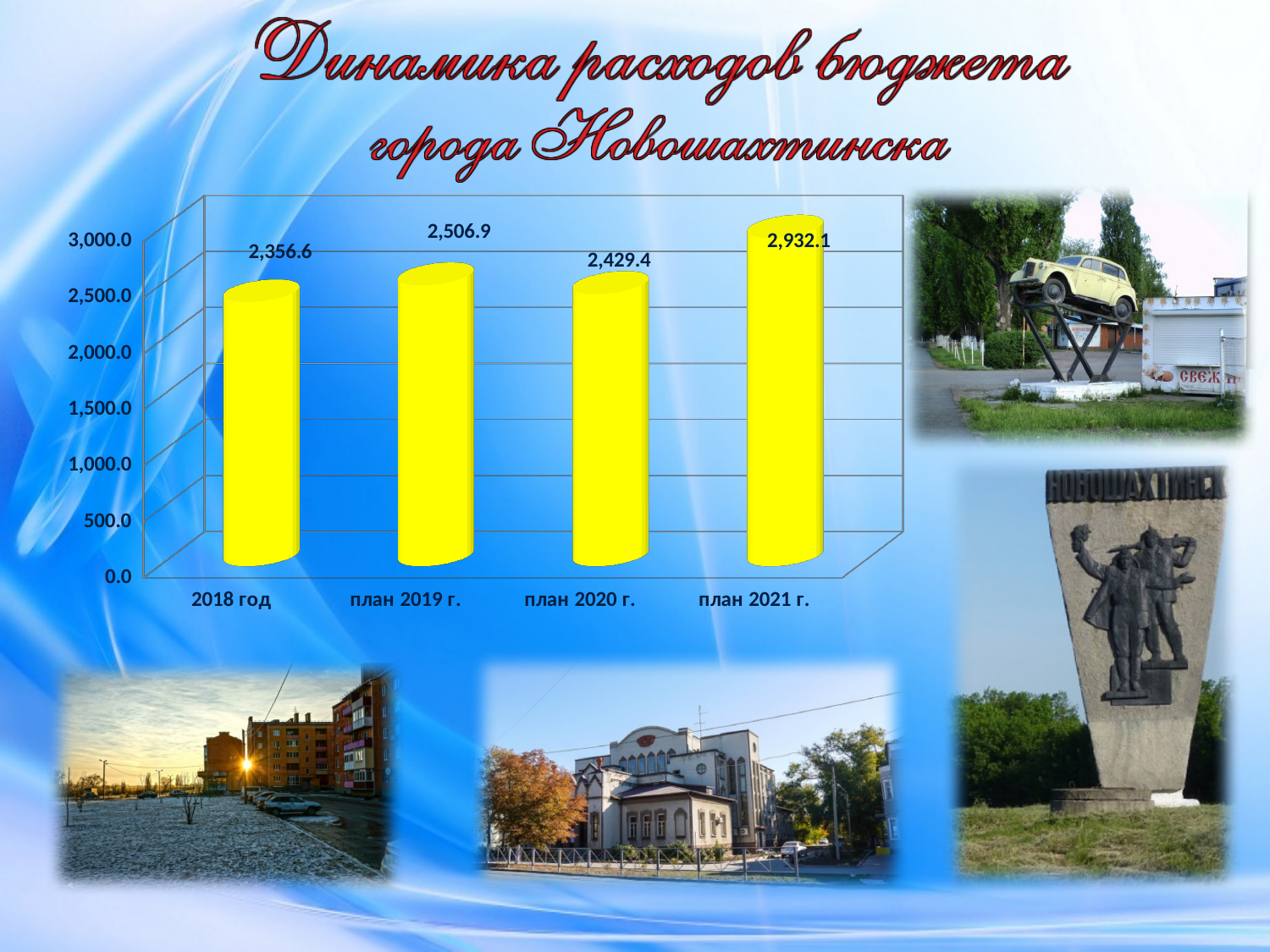
Is the value for 2018 год greater or less than 2,500.0? less What is the value for план 2021 г.? 2,932.1 Which is larger, the value for план 2019 г. or план 2020 г.? план 2019 г. What is the value for план 2019 г.? 2,506.9 Which category has the highest value? план 2021 г. What is the value for 2018 год? 2,356.6 How many categories are shown on the x axis? 4 What is the difference between the values for план 2019 г. and план 2020 г.? 77.5 What kind of chart is shown on the slide? bar chart What is the value for план 2020 г.? 2,429.4 What is the difference between the values for план 2021 г. and 2018 год? 575.5 Which category has the lowest value? 2018 год